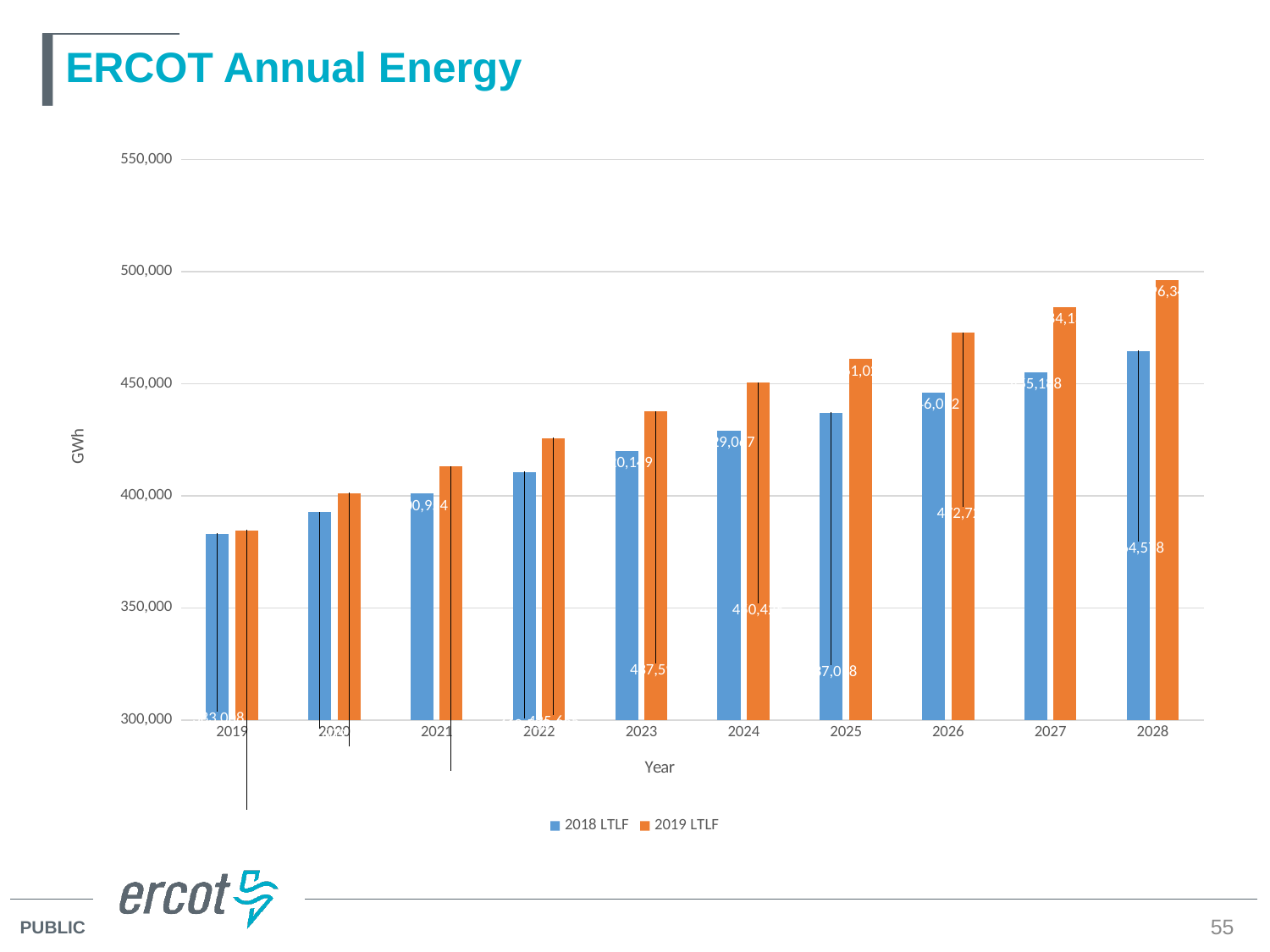
Which year has the lowest 2018 LTLF value? 2019 Do the 2019 LTLF values rise or fall from 2019 to 2028? rise Is the 2018 LTLF value for 2019 greater or less than 400,000? less Which year has the highest 2019 LTLF value? 2028 Is the 2018 LTLF value for 2025 greater or less than 450,000? less Is the 2019 LTLF value for 2028 greater or less than 450,000? greater What kind of chart is shown on the slide? bar chart How many years are shown on the x axis? 10 What unit is shown on the y axis label? GWh For 2028, which series has the larger value, 2018 LTLF or 2019 LTLF? 2019 LTLF How many series does the legend list? 2